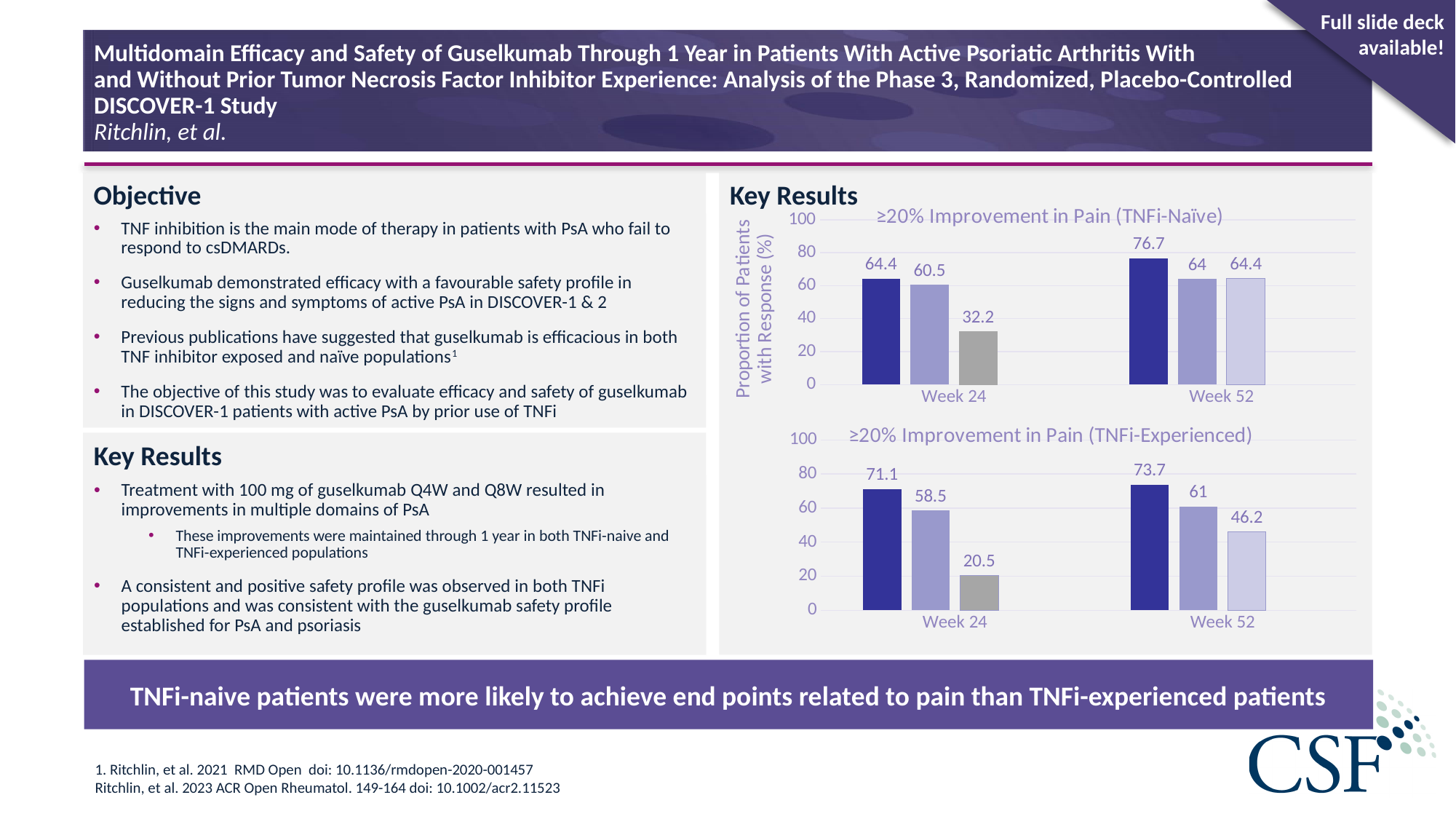
In the "≥20% Improvement in Pain (TNFi-Naïve)" chart, what is the highest value shown? 76.7 In the "≥20% Improvement in Pain (TNFi-Experienced)" chart, what is the difference between the second bar (61) and the third bar (46.2) at Week 52? 14.8 In the "≥20% Improvement in Pain (TNFi-Experienced)" chart, what is the lowest value shown? 20.5 In the "≥20% Improvement in Pain (TNFi-Naïve)" chart, does the dark blue bar rise or fall from Week 24 to Week 52? rise How many x-axis categories does the "≥20% Improvement in Pain (TNFi-Experienced)" chart have? 2 In the "≥20% Improvement in Pain (TNFi-Naïve)" chart, what is the value of the dark blue (first) bar at Week 52? 76.7 What is the y-axis label of the "≥20% Improvement in Pain (TNFi-Naïve)" chart? Proportion of Patients with Response (%) In the "≥20% Improvement in Pain (TNFi-Experienced)" chart, what is the value of the grey (third) bar at Week 24? 20.5 In the "≥20% Improvement in Pain (TNFi-Experienced)" chart, which is larger: the dark blue bar at Week 24 or the dark blue bar at Week 52? Week 52 What kind of chart is the "≥20% Improvement in Pain (TNFi-Naïve)" chart? bar chart In the "≥20% Improvement in Pain (TNFi-Naïve)" chart, what is the difference between the first bar (64.4) and the third bar (32.2) at Week 24? 32.2 In the "≥20% Improvement in Pain (TNFi-Experienced)" chart, is the value of the third bar at Week 52 greater or less than 40? greater